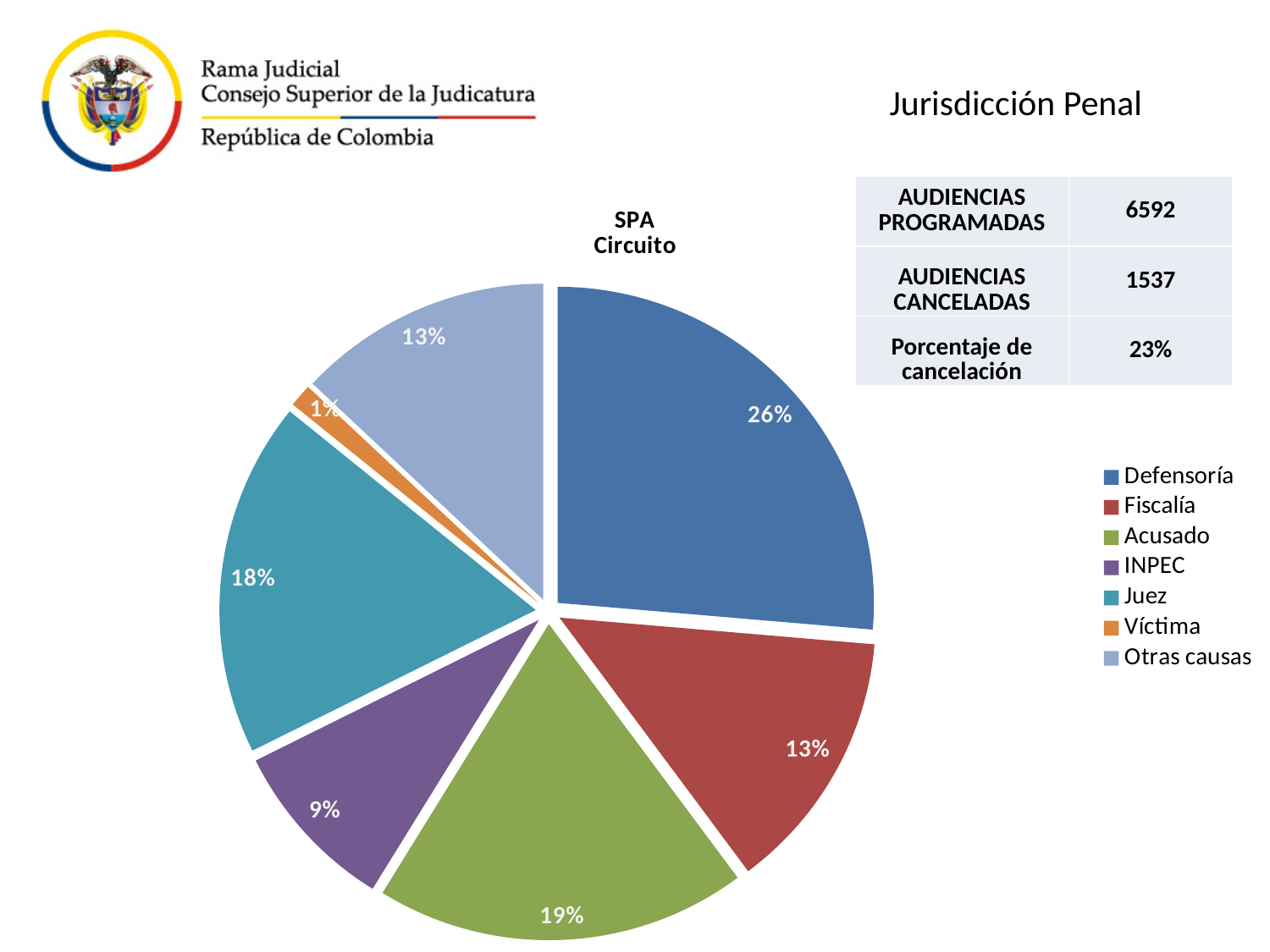
How many categories does the legend list? 7 Which slice is larger, Juez or INPEC? Juez Which category has the largest slice of the pie? Defensoría What is the difference in percentage points between the Defensoría slice and the Acusado slice? 7% What share of the pie does INPEC represent? 9% What type of chart is shown on the slide? pie chart What share of the pie does Acusado represent? 19% What share of the pie does Defensoría represent? 26% Which category has the smallest slice of the pie? Víctima What is the title of the pie chart? SPA Circuito